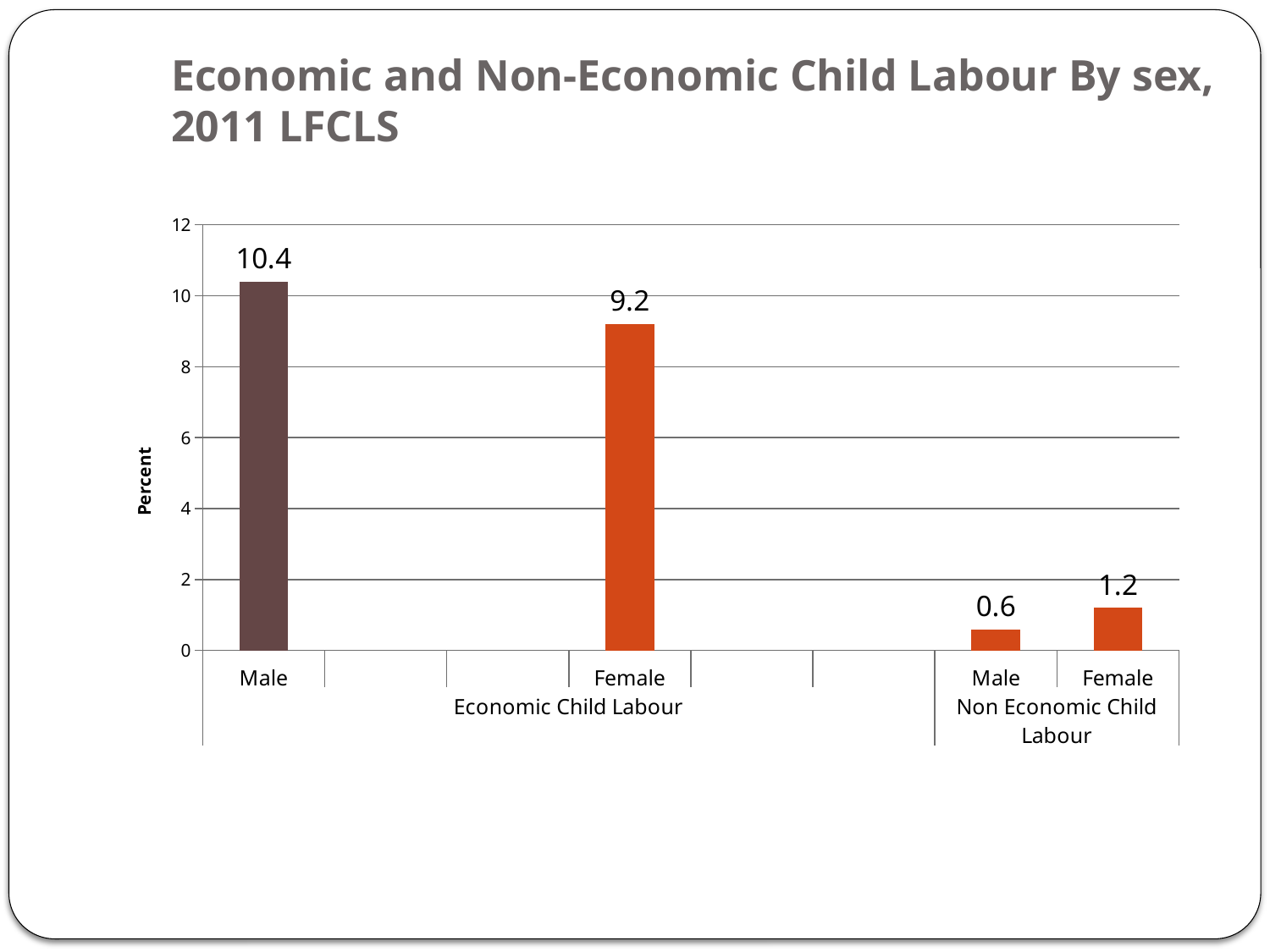
What is the value for Male under Economic Child Labour? 10.4 What is the difference between the Male and Female values for Economic Child Labour? 1.2 What is the label on the vertical axis? Percent Which bar has the lowest value? Male, Non Economic Child Labour What is the value for Female under Non Economic Child Labour? 1.2 What kind of chart is shown? Bar chart What is the value for Male under Non Economic Child Labour? 0.6 What is the difference between the Female and Male values for Non Economic Child Labour? 0.6 Which bar has the highest value? Male, Economic Child Labour How many bars are plotted on the chart? 4 Which is larger: the Male value for Economic Child Labour or the Female value for Economic Child Labour? Male What is the value for Female under Economic Child Labour? 9.2